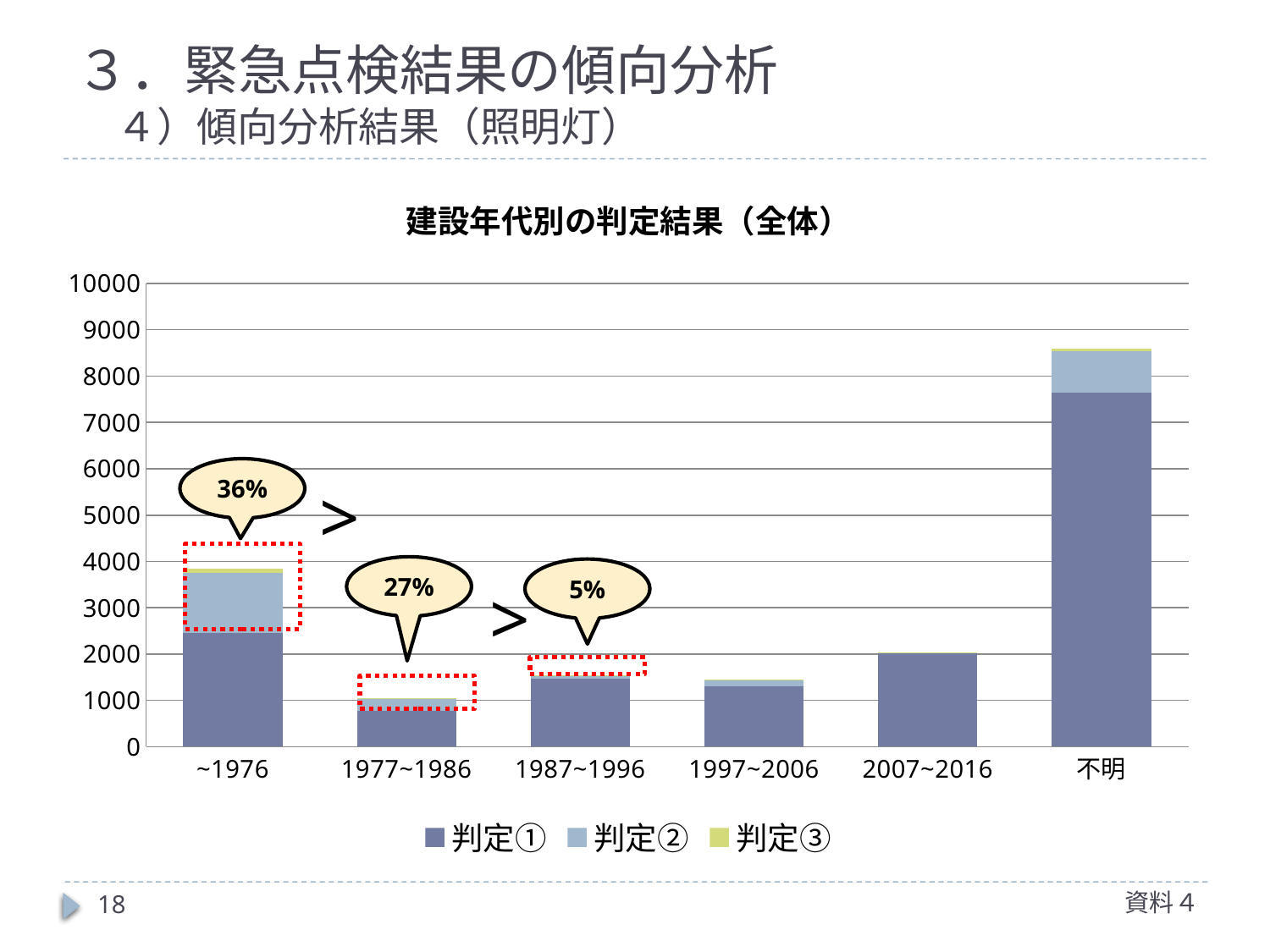
What percentage is shown in the callout above the ~1976 bar? 36% Is the 判定① value for 不明 greater or less than 7000? greater Which category has the tallest stacked bar? 不明 Is the total stacked value for ~1976 greater or less than 4000? less Is the total stacked value for 不明 greater or less than 8000? greater How many series does the legend list? 3 Which category has the shortest stacked bar? 1977~1986 What kind of chart is shown on the slide? Stacked bar chart What is the title of the chart? 建設年代別の判定結果（全体） Which stacked bar is taller, ~1976 or 2007~2016? ~1976 How many construction-period categories are shown on the x axis? 6